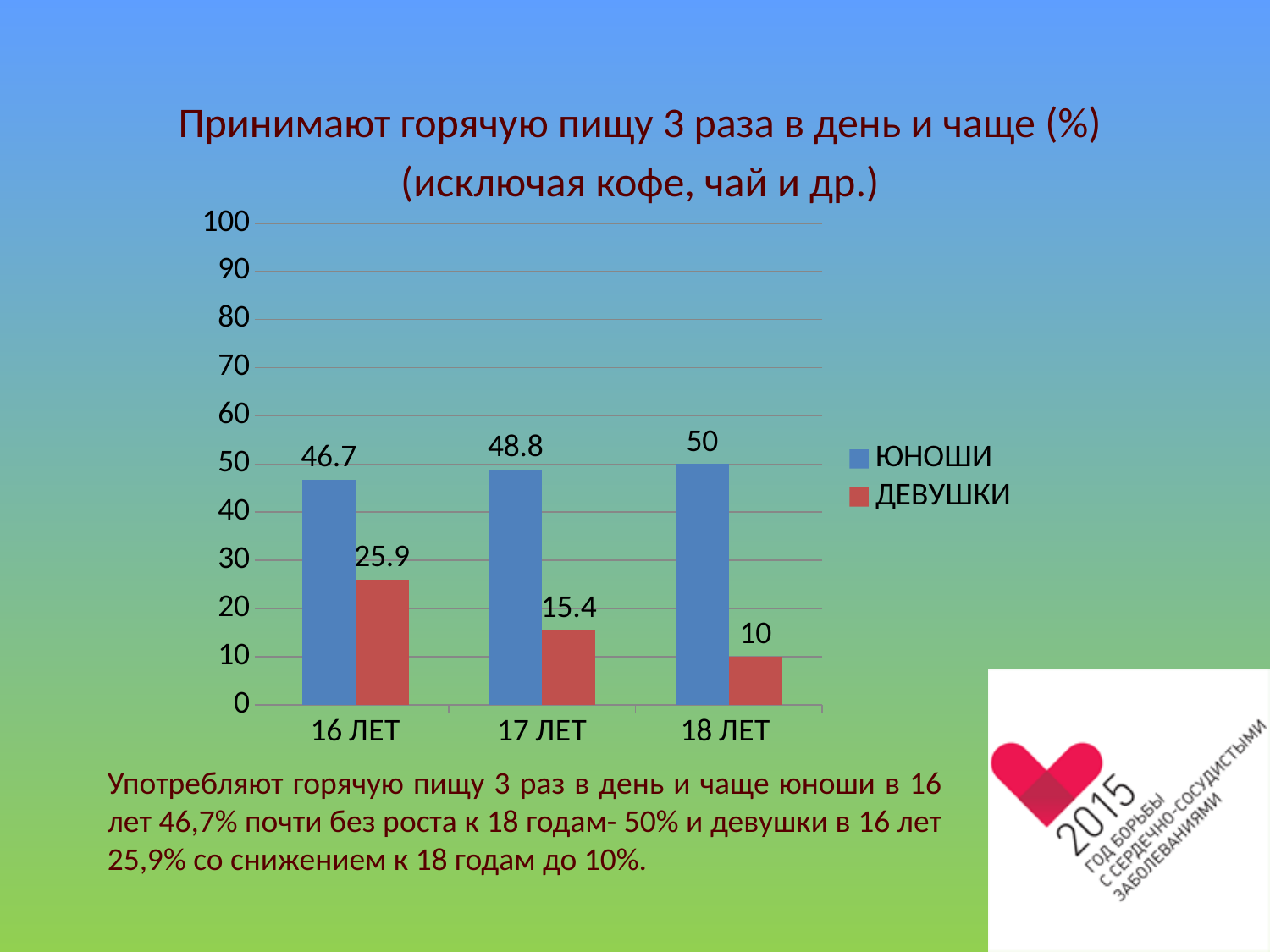
What is the value for ДЕВУШКИ at 18 ЛЕТ? 10 What is the difference between the ЮНОШИ and ДЕВУШКИ values at 16 ЛЕТ? 20.8 Is the value for ДЕВУШКИ at 16 ЛЕТ greater or less than 20? greater How many series does the legend list? 2 Do the values for ДЕВУШКИ rise or fall from 16 ЛЕТ to 18 ЛЕТ? fall What is the value for ДЕВУШКИ at 17 ЛЕТ? 15.4 At which age group is the value for ДЕВУШКИ lowest? 18 ЛЕТ At which age group is the value for ЮНОШИ highest? 18 ЛЕТ Which is larger at 17 ЛЕТ: the value for ЮНОШИ or for ДЕВУШКИ? ЮНОШИ What kind of chart is shown on the slide? bar chart What is the value for ЮНОШИ at 16 ЛЕТ? 46.7 How many age groups are shown on the x axis? 3